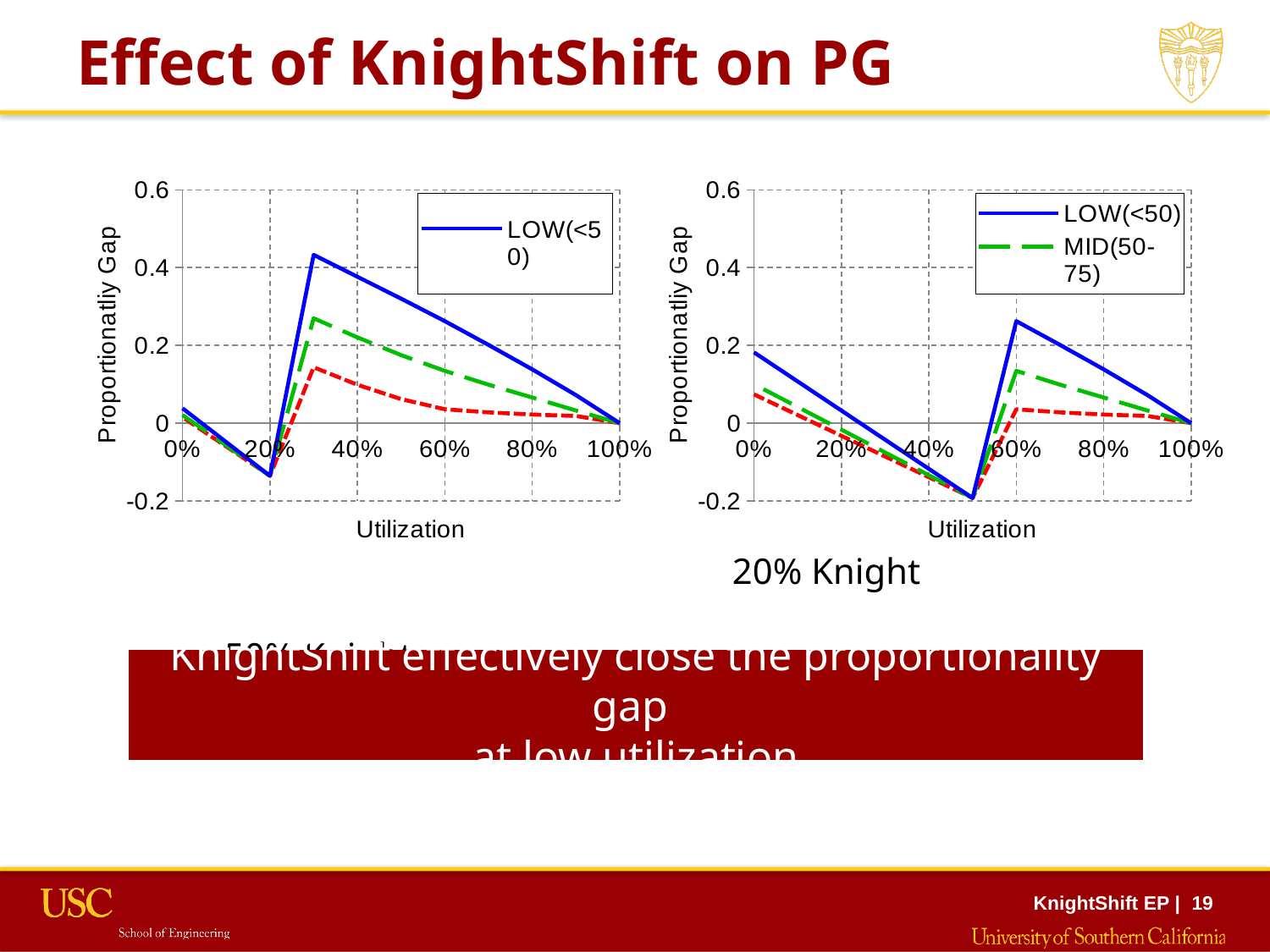
In the right chart (20% Knight), what are the two series named in the legend? LOW(<50) and MID(50-75) In the left chart, is the value of LOW(<50) at 20% utilization greater or less than 0? less In the right chart (20% Knight), is the value of MID(50-75) at 60% utilization greater or less than 0.2? less In the right chart (20% Knight), is the value of LOW(<50) at 60% utilization greater or less than 0.2? greater In the left chart, at 40% utilization, which series has the larger value, LOW(<50) or MID(50-75)? LOW(<50) In the right chart (20% Knight), which series reaches the highest peak value? LOW(<50) What is the x-axis title of the left chart? Utilization In the right chart (20% Knight), how many series does the legend list? 2 What kind of chart is the left chart on the slide? line chart In the right chart (20% Knight), what is the value of LOW(<50) at 100% utilization? 0 In the left chart, does the LOW(<50) line rise or fall between 40% and 100% utilization? fall